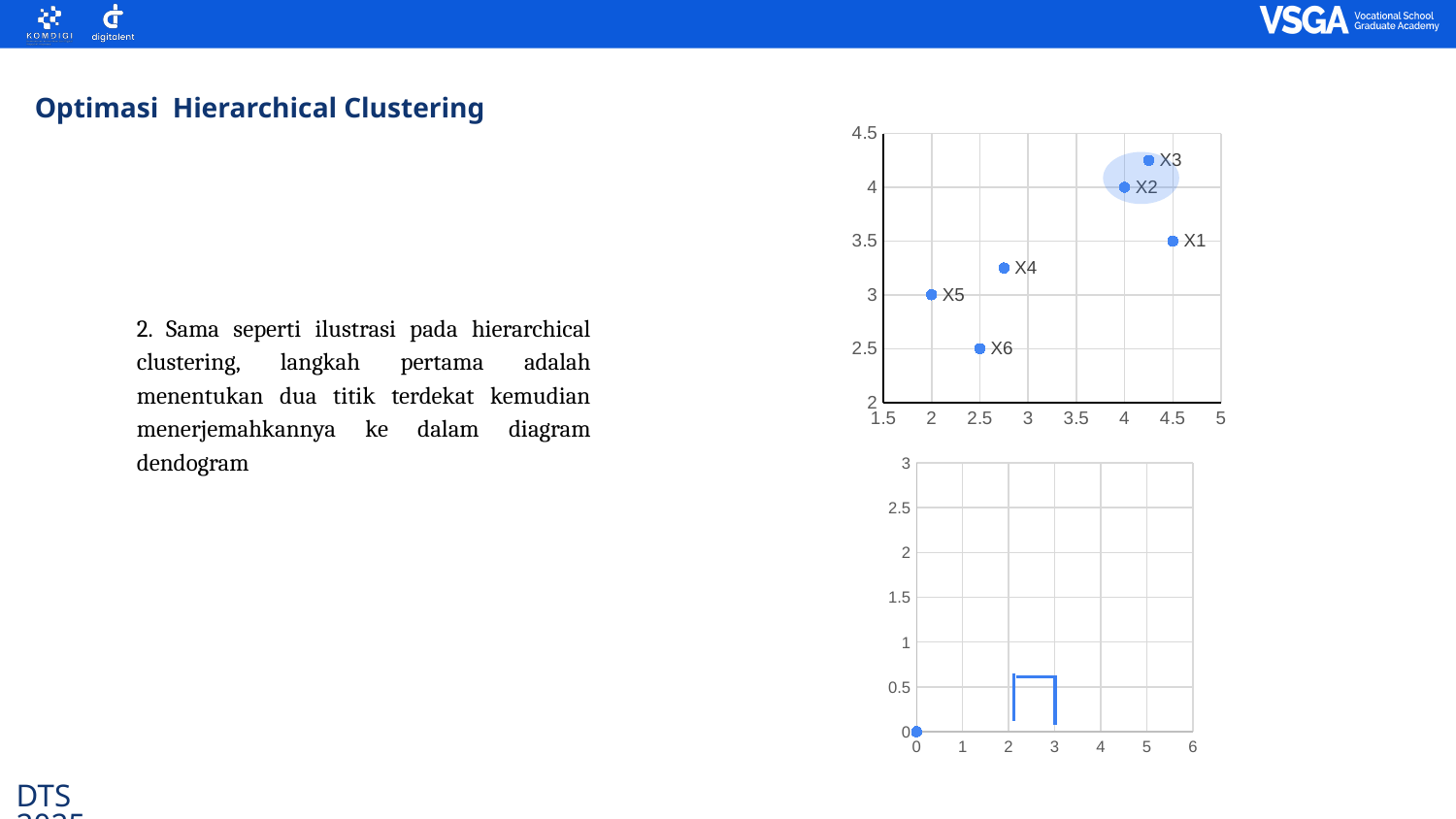
In the top scatter chart, which two points are enclosed by the shaded ellipse? X2 and X3 In the top scatter chart, what is the y value of point X5? 3 In the top scatter chart, is the y value of X4 greater or less than 3? greater In the top scatter chart, which point is furthest to the right (largest x value)? X1 In the top scatter chart, what is the x value of point X2? 4 In the top scatter chart, which point has the highest vertical (y) value? X3 In the top scatter chart, which point is furthest to the left (smallest x value)? X5 In the bottom chart, is the height of the bracket (link) drawn between x=2 and x=3 greater or less than 1? less What kind of chart is the top chart on the slide? scatter chart In the top scatter chart, which point has a larger y value, X1 or X2? X2 In the top scatter chart, which point has the lowest vertical (y) value? X6 In the top scatter chart, how many labelled data points are plotted? 6